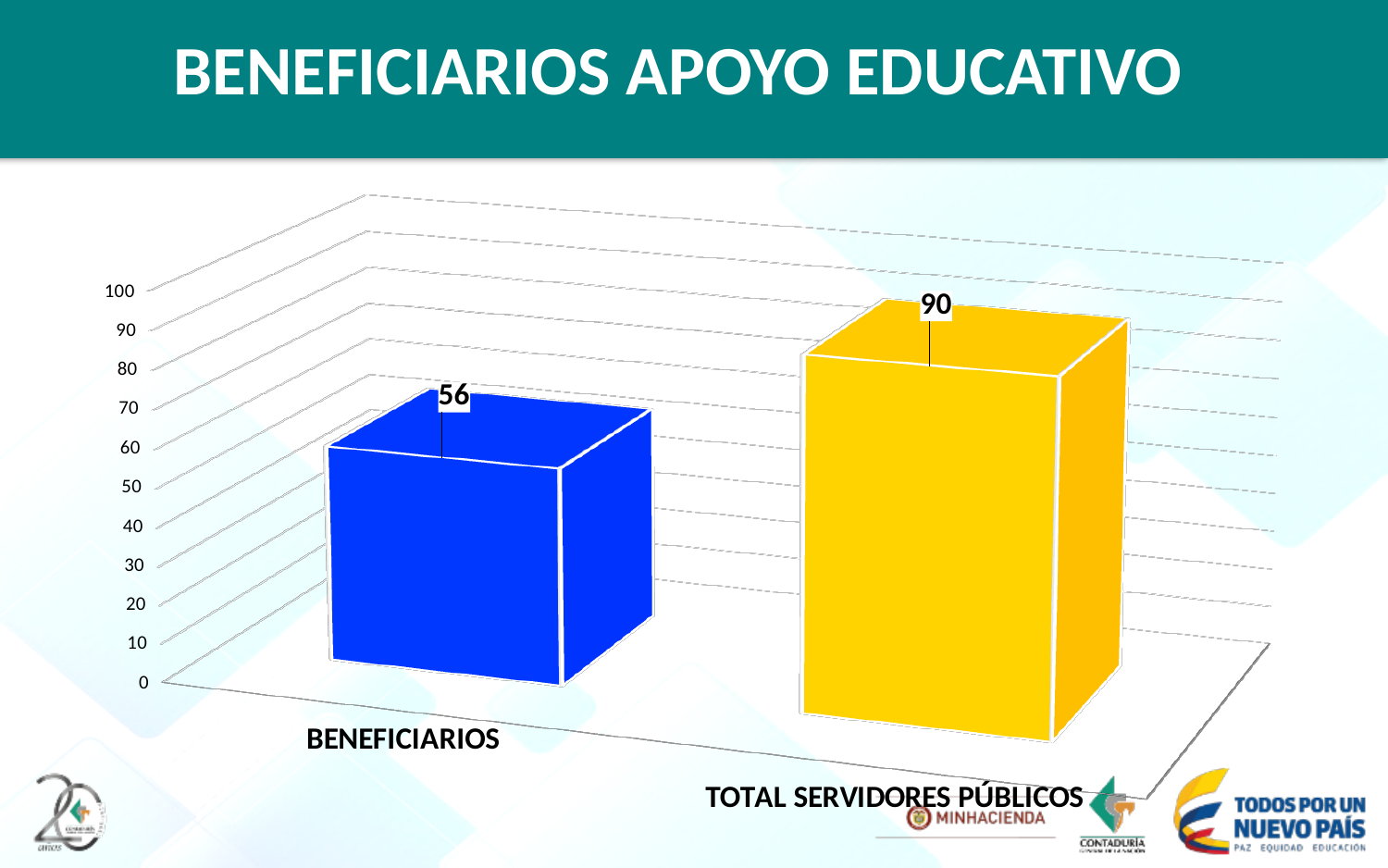
Which category has the lowest value? BENEFICIARIOS What is the difference between the values for TOTAL SERVIDORES PÚBLICOS and BENEFICIARIOS? 34 Which is larger, the value for BENEFICIARIOS or the value for TOTAL SERVIDORES PÚBLICOS? TOTAL SERVIDORES PÚBLICOS What kind of chart is shown on the slide? bar chart What is the title of the slide? BENEFICIARIOS APOYO EDUCATIVO Which category has the highest value? TOTAL SERVIDORES PÚBLICOS What is the value for TOTAL SERVIDORES PÚBLICOS? 90 What is the value for BENEFICIARIOS? 56 How many categories are shown in the chart? 2 What colour is the bar for BENEFICIARIOS? blue Is the value for BENEFICIARIOS greater or less than 60? less Is the value for TOTAL SERVIDORES PÚBLICOS greater or less than 80? greater